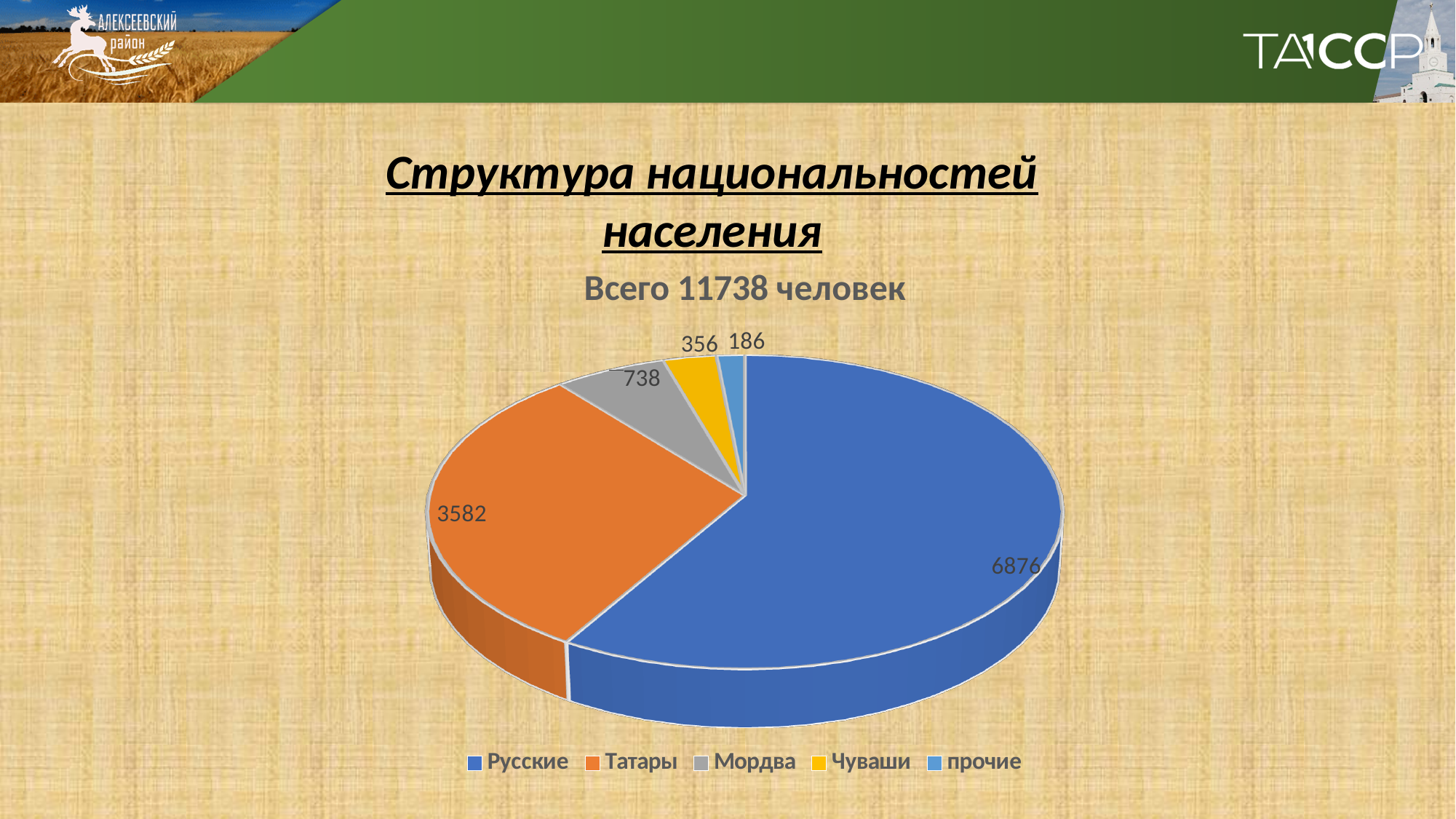
How many categories does the pie chart have? 5 What is the value for Мордва? 738 What is the difference between the values for Русские and Татары? 3294 What is the value for Чуваши? 356 What kind of chart is shown on the slide? pie chart What is the value for Татары? 3582 Which category has the largest slice? Русские What total number of people is stated in the chart title? 11738 What is the value for прочие? 186 Which is larger, the value for Мордва or the value for Чуваши? Мордва Which category has the smallest slice? прочие What is the value for Русские? 6876